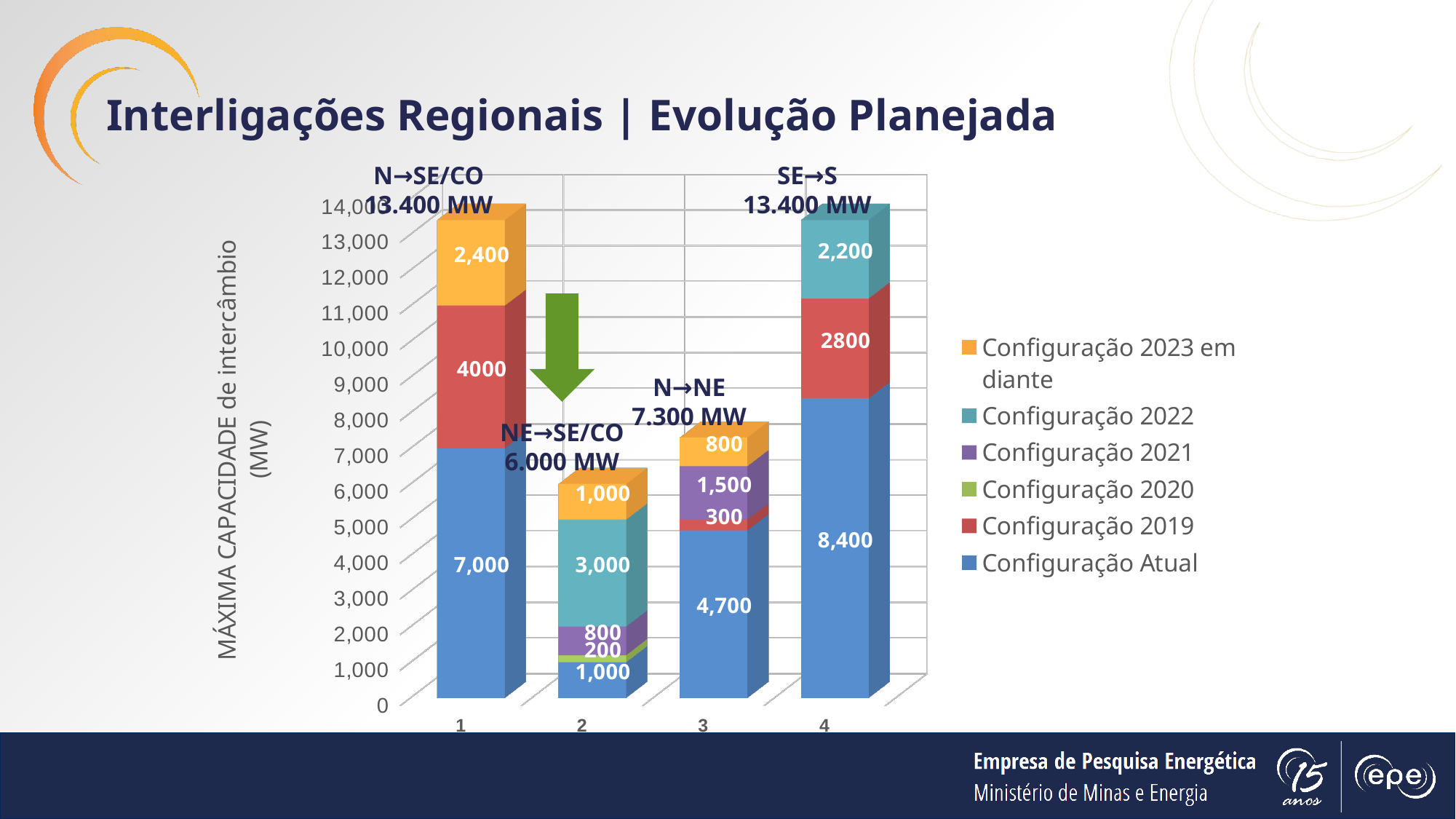
What is the Configuração 2021 value for bar 3 (N→NE)? 1,500 Which is larger: the Configuração 2023 em diante value for bar 1 (N→SE/CO) or for bar 3 (N→NE)? bar 1 (N→SE/CO) What is the difference between the Configuração Atual values of bar 4 (SE→S) and bar 1 (N→SE/CO)? 1,400 Which bar has the smallest Configuração Atual value? 2 (NE→SE/CO) How many series does the legend list? 6 What is the Configuração Atual value for bar 4 (SE→S)? 8,400 What is the total capacity shown for the NE→SE/CO interconnection (bar 2)? 6.000 MW What is the Configuração 2019 value for bar 1 (N→SE/CO)? 4000 What type of chart is shown on the slide? stacked bar chart How many bars are plotted in the chart? 4 What is the Configuração 2022 value for bar 2 (NE→SE/CO)? 3,000 Which series is shown in green in the legend? Configuração 2020